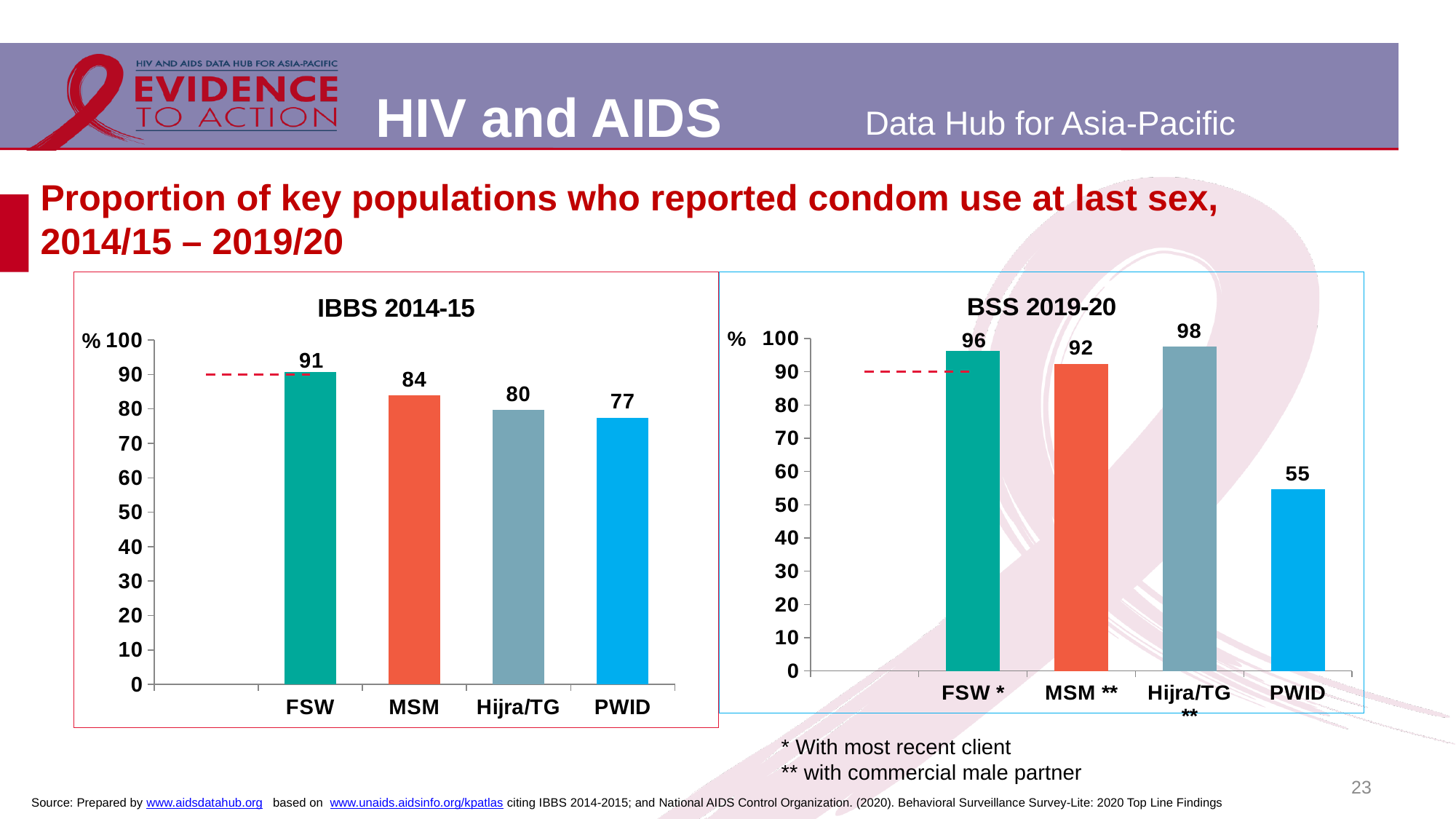
In the BSS 2019-20 chart, what is the value for PWID? 55 In the IBBS 2014-15 chart, what is the value for FSW? 91 In the BSS 2019-20 chart, is the value for PWID greater or less than 60? less In the BSS 2019-20 chart, what is the difference between the values for FSW * and PWID? 41 In the IBBS 2014-15 chart, which category has the lowest value? PWID In the IBBS 2014-15 chart, which is larger, the value for MSM or the value for PWID? MSM In the BSS 2019-20 chart, which category has the highest value? Hijra/TG ** In the IBBS 2014-15 chart, do the values rise or fall from FSW to PWID along the x axis? fall What kind of chart is the BSS 2019-20 chart? bar chart How many categories are shown in the IBBS 2014-15 chart? 4 In the IBBS 2014-15 chart, what is the difference between the values for MSM and Hijra/TG? 4 What is the title of the chart on the right side of the slide? BSS 2019-20